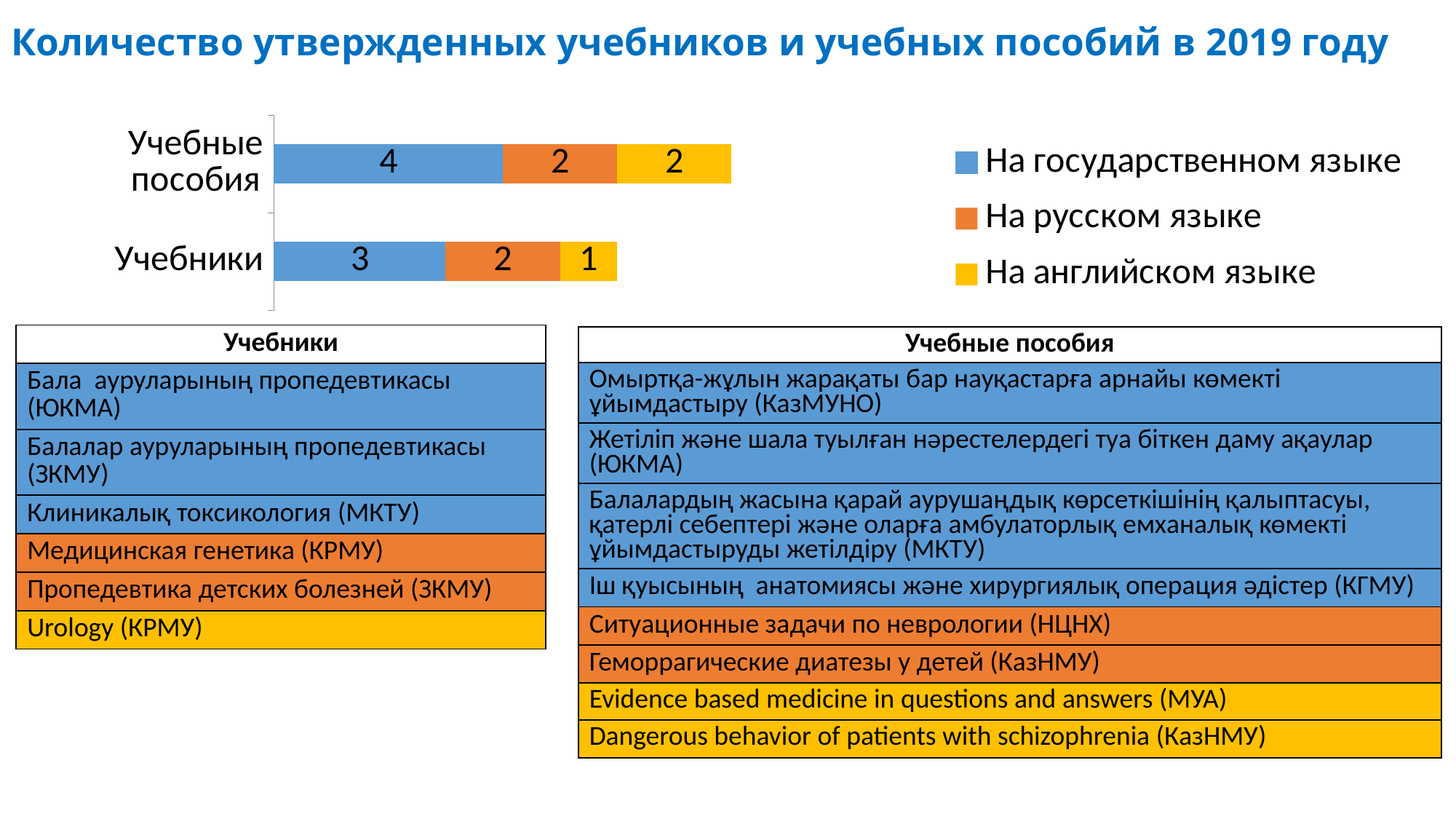
What is the value for 'На русском языке' in the 'Учебники' category? 2 What colour represents 'На русском языке' in the chart? Orange How many series does the legend list? 3 Which series has the highest value in the 'Учебники' category? На государственном языке What is the value for 'На английском языке' in the 'Учебники' category? 1 What is the value for 'На государственном языке' in the 'Учебные пособия' category? 4 What type of chart is shown on the slide? Stacked bar chart What is the total of the stacked bar for 'Учебные пособия'? 8 How many categories are shown on the chart? 2 What is the total of the stacked bar for 'Учебники'? 6 What is the difference between the 'На государственном языке' values for 'Учебные пособия' and 'Учебники'? 1 Which category has the higher value for 'На английском языке', 'Учебные пособия' or 'Учебники'? Учебные пособия